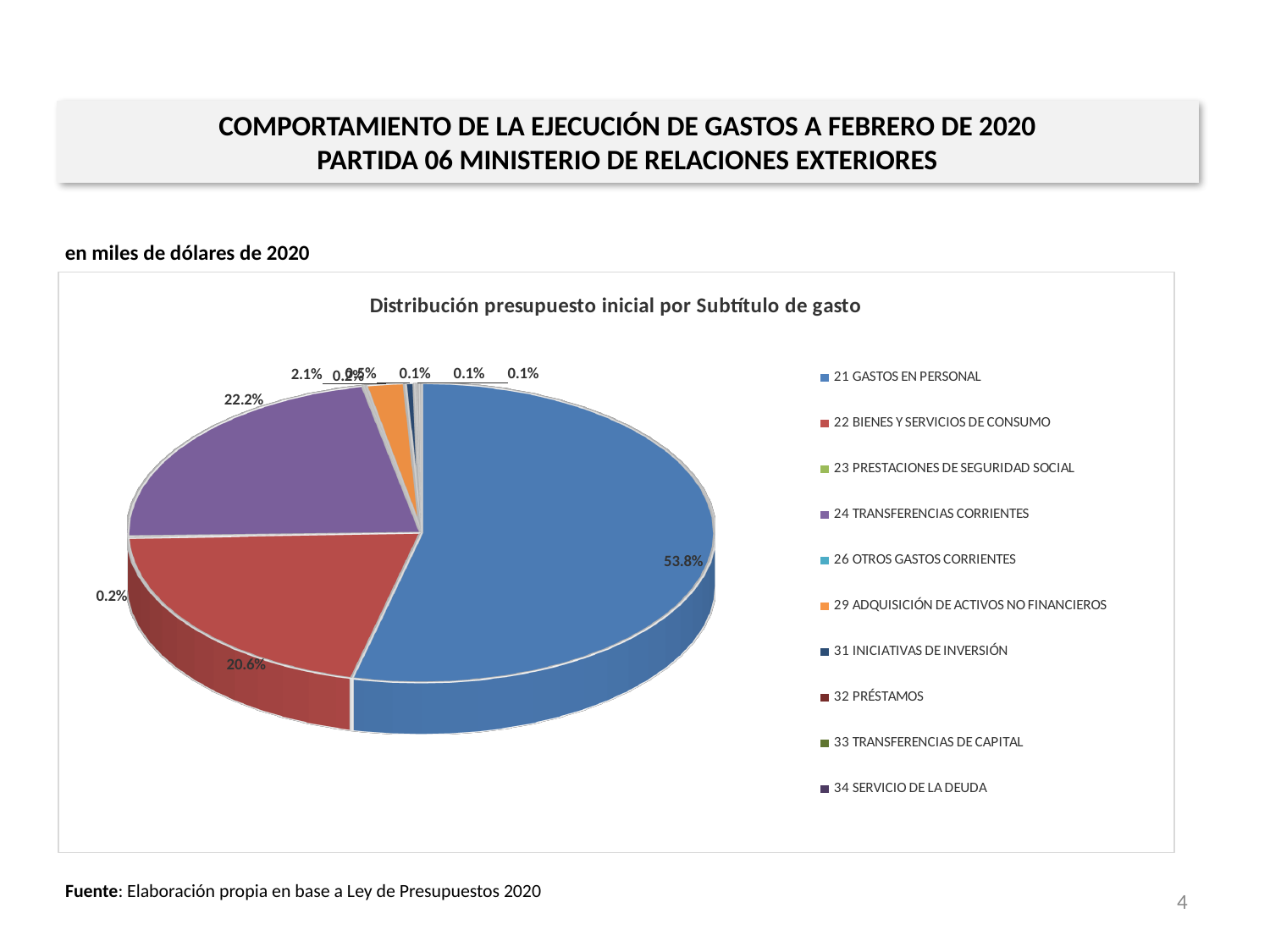
How many categories does the legend list? 10 What is the title of the chart? Distribución presupuesto inicial por Subtítulo de gasto By how many percentage points does 21 GASTOS EN PERSONAL exceed 24 TRANSFERENCIAS CORRIENTES? 31.6 percentage points What percentage is shown for 29 ADQUISICIÓN DE ACTIVOS NO FINANCIEROS? 2.1% What percentage is shown for 24 TRANSFERENCIAS CORRIENTES? 22.2% Which has a larger share: 22 BIENES Y SERVICIOS DE CONSUMO or 24 TRANSFERENCIAS CORRIENTES? 24 TRANSFERENCIAS CORRIENTES What is the combined share of 21 GASTOS EN PERSONAL, 22 BIENES Y SERVICIOS DE CONSUMO and 24 TRANSFERENCIAS CORRIENTES? 96.6% Which subtítulo has the largest share of the initial budget? 21 GASTOS EN PERSONAL By how many percentage points does 24 TRANSFERENCIAS CORRIENTES exceed 22 BIENES Y SERVICIOS DE CONSUMO? 1.6 percentage points What kind of chart is shown on the slide? Pie chart What share of the initial budget goes to 21 GASTOS EN PERSONAL? 53.8% What percentage is shown for 22 BIENES Y SERVICIOS DE CONSUMO? 20.6%